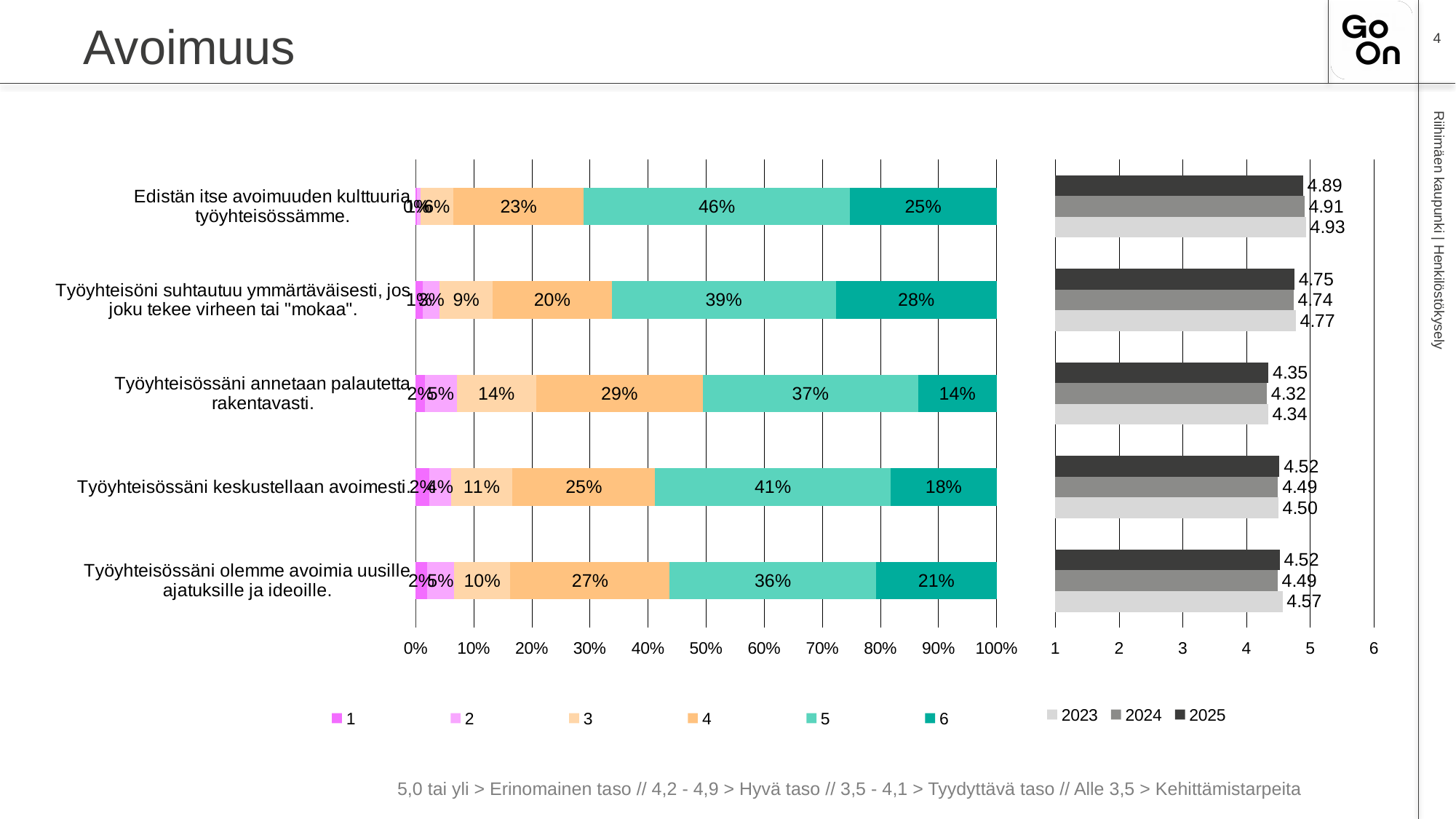
On the left stacked bar chart, what percentage gave a rating of 4 for "Työyhteisössäni annetaan palautetta rakentavasti."? 29% On the right bar chart, what is the 2023 value for "Työyhteisössäni olemme avoimia uusille ajatuksille ja ideoille."? 4.57 On the left stacked bar chart, what is the difference between the rating-5 share for "Työyhteisössäni keskustellaan avoimesti." and for "Työyhteisössäni olemme avoimia uusille ajatuksille ja ideoille."? 5% Which years does the legend of the right bar chart list? 2023, 2024, 2025 On the left stacked bar chart, which statement has the lowest share of rating 6? Työyhteisössäni annetaan palautetta rakentavasti. On the left stacked bar chart, what percentage of respondents gave a rating of 5 for "Edistän itse avoimuuden kulttuuria työyhteisössämme."? 46% How many series does the legend of the left stacked bar chart list? 6 On the right bar chart, which statement has the lowest 2025 value? Työyhteisössäni annetaan palautetta rakentavasti. On the right bar chart, what is the 2025 value for "Edistän itse avoimuuden kulttuuria työyhteisössämme."? 4.89 On the left stacked bar chart, which statement has the highest share of rating 6? Työyhteisöni suhtautuu ymmärtäväisesti, jos joku tekee virheen tai "mokaa". On the left stacked bar chart, what percentage gave a rating of 6 for "Työyhteisöni suhtautuu ymmärtäväisesti, jos joku tekee virheen tai 'mokaa'."? 28% On the right bar chart, is the 2024 value for "Työyhteisössäni annetaan palautetta rakentavasti." larger or smaller than the 2024 value for "Työyhteisössäni keskustellaan avoimesti."? smaller